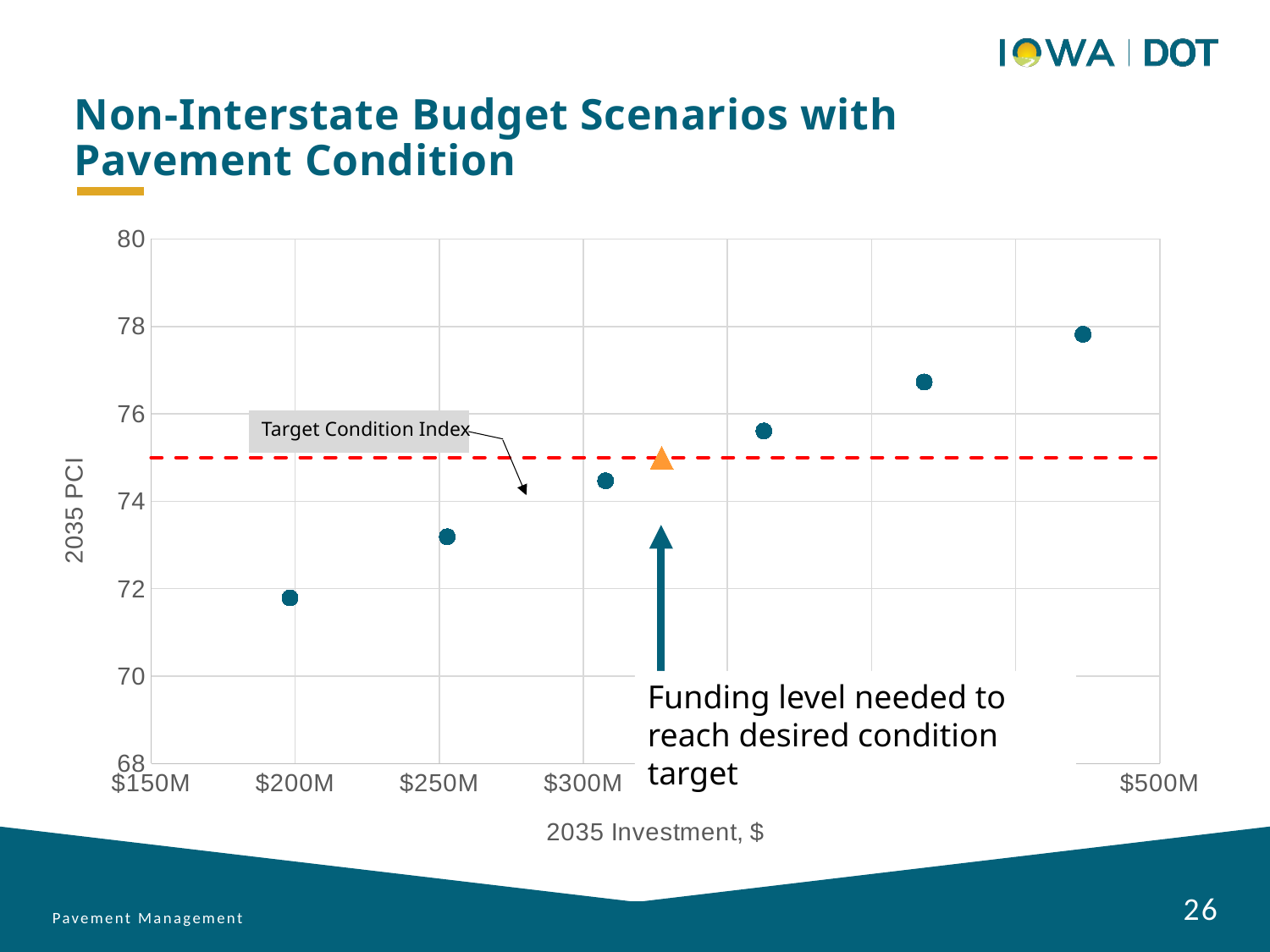
What is the label of the y axis? 2035 PCI Is the 2035 PCI value at $300M investment greater or less than 76? less Is the 2035 PCI value at $500M investment greater or less than 76? greater Do the 2035 PCI values rise or fall as the 2035 investment increases along the x axis? Rise Which has the higher 2035 PCI: the point at $250M or the point at $300M? $300M How many blue data points are plotted on the chart? 6 Is the 2035 PCI value at $250M investment greater or less than 74? less What does the red dashed horizontal line represent, according to its label? Target Condition Index What kind of chart is shown on the slide? Scatter chart